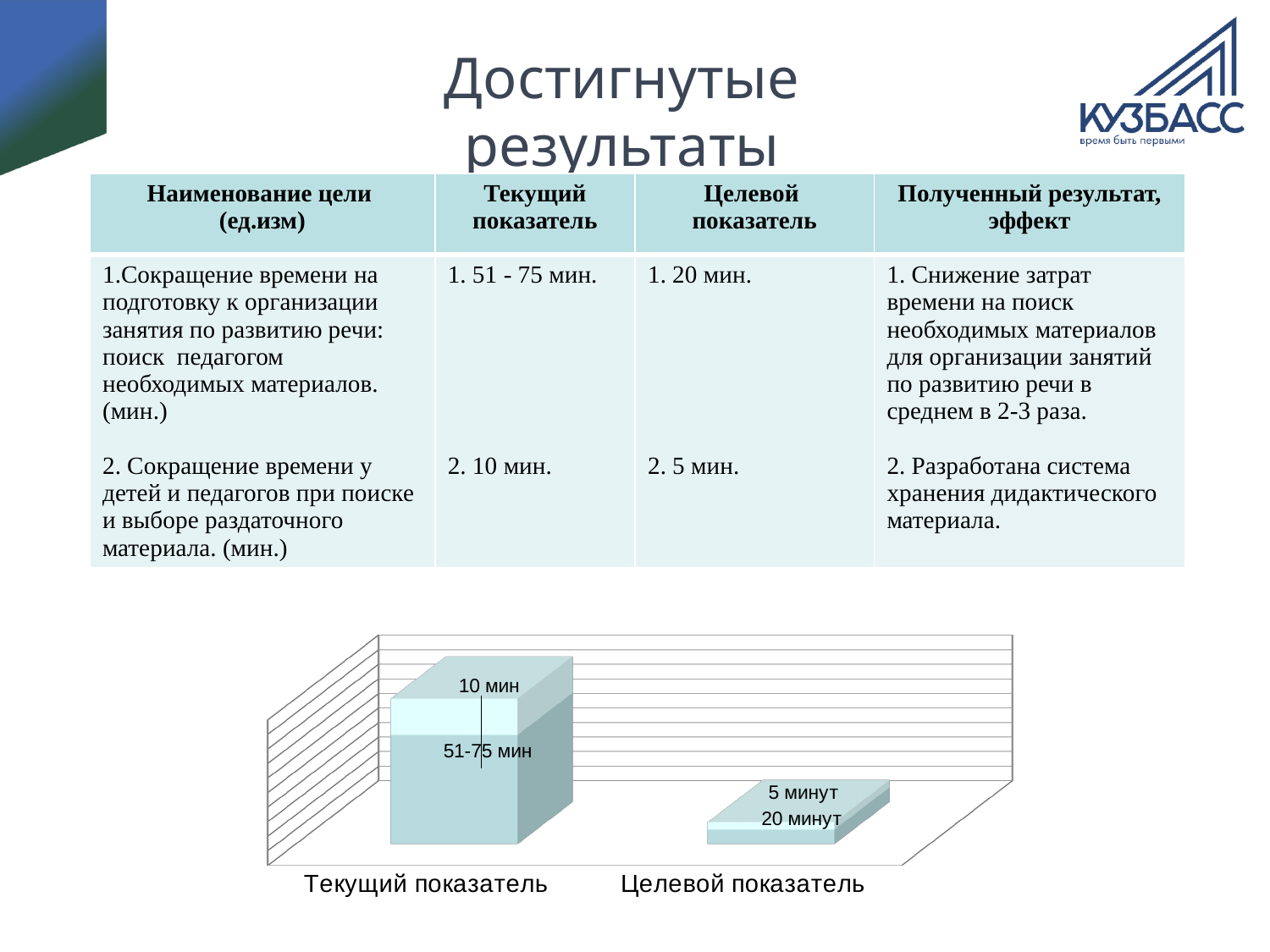
Which category has the taller bar in the chart? Текущий показатель How many segments does each stacked bar in the chart have? 2 What value label is printed on the lower segment of the Целевой показатель bar? 20 минут What are the two category labels on the x axis of the chart? Текущий показатель, Целевой показатель How many categories are shown on the x axis of the chart? 2 Do the bars get taller or shorter moving from left to right along the x axis? shorter What kind of chart is shown on the slide? bar chart What value label is printed on the lower segment of the Текущий показатель bar? 51-75 мин What value label is printed on the upper segment of the Текущий показатель bar? 10 мин Which bar is taller: Текущий показатель or Целевой показатель? Текущий показатель Which category has the shorter bar in the chart? Целевой показатель What value label is printed on the upper segment of the Целевой показатель bar? 5 минут